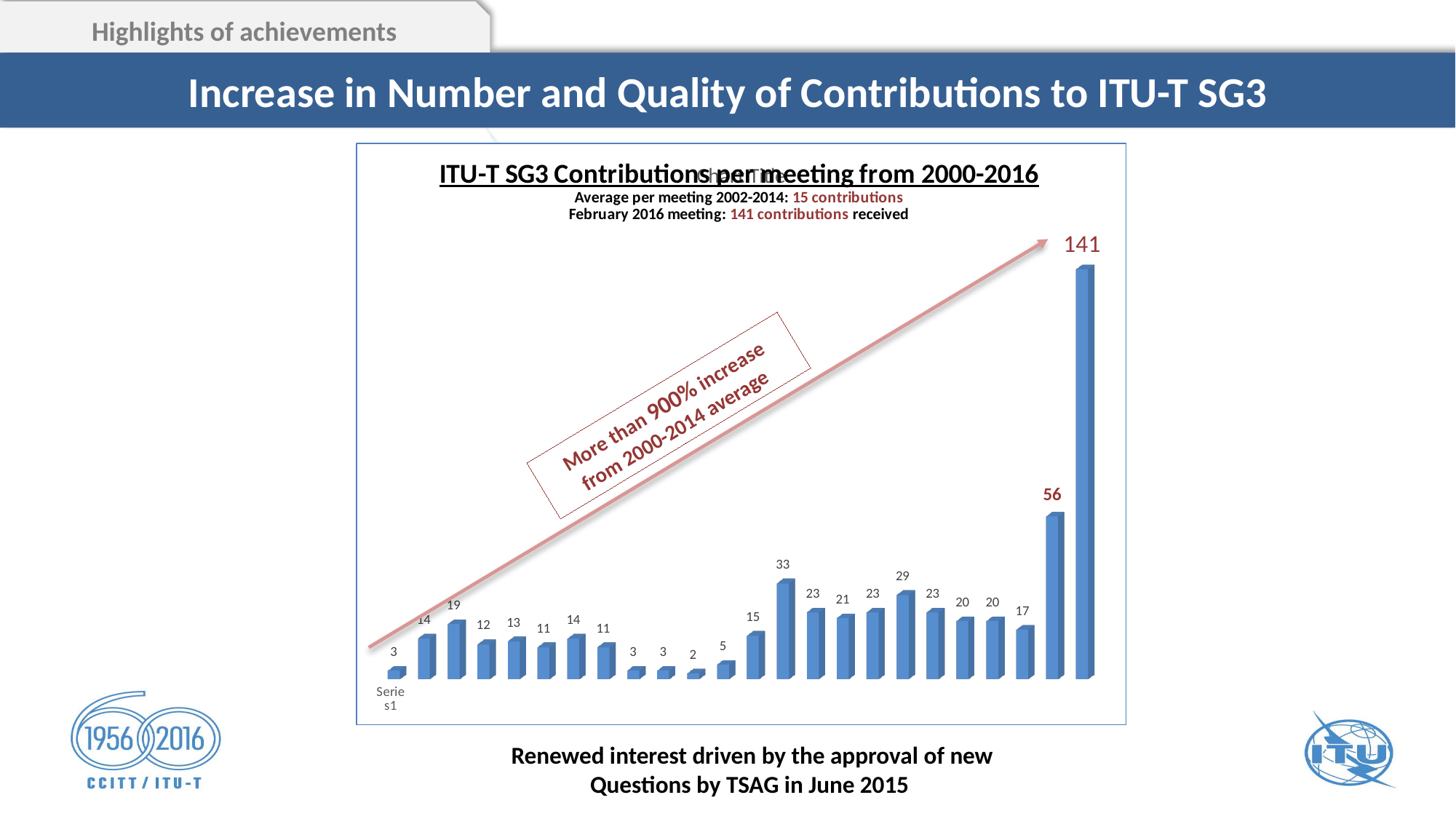
How many bars are plotted in the chart? 24 Is the value of the tallest bar greater or less than 100? greater What is the value of the second-to-last bar in the chart? 56 What is the lowest value shown by any bar in the chart? 2 What does the rotated red annotation on the chart say? More than 900% increase from 2000-2014 average What is the difference between the last bar (141) and the second-to-last bar (56)? 85 What kind of chart is shown on the slide? bar chart What is the value of the first (leftmost) bar in the chart? 3 What is the highest value shown by any bar in the chart? 141 Which is larger, the last bar or the second-to-last bar? the last bar What is the title of the chart? ITU-T SG3 Contributions per meeting from 2000-2016 How many bars in the chart have the value 23? 3